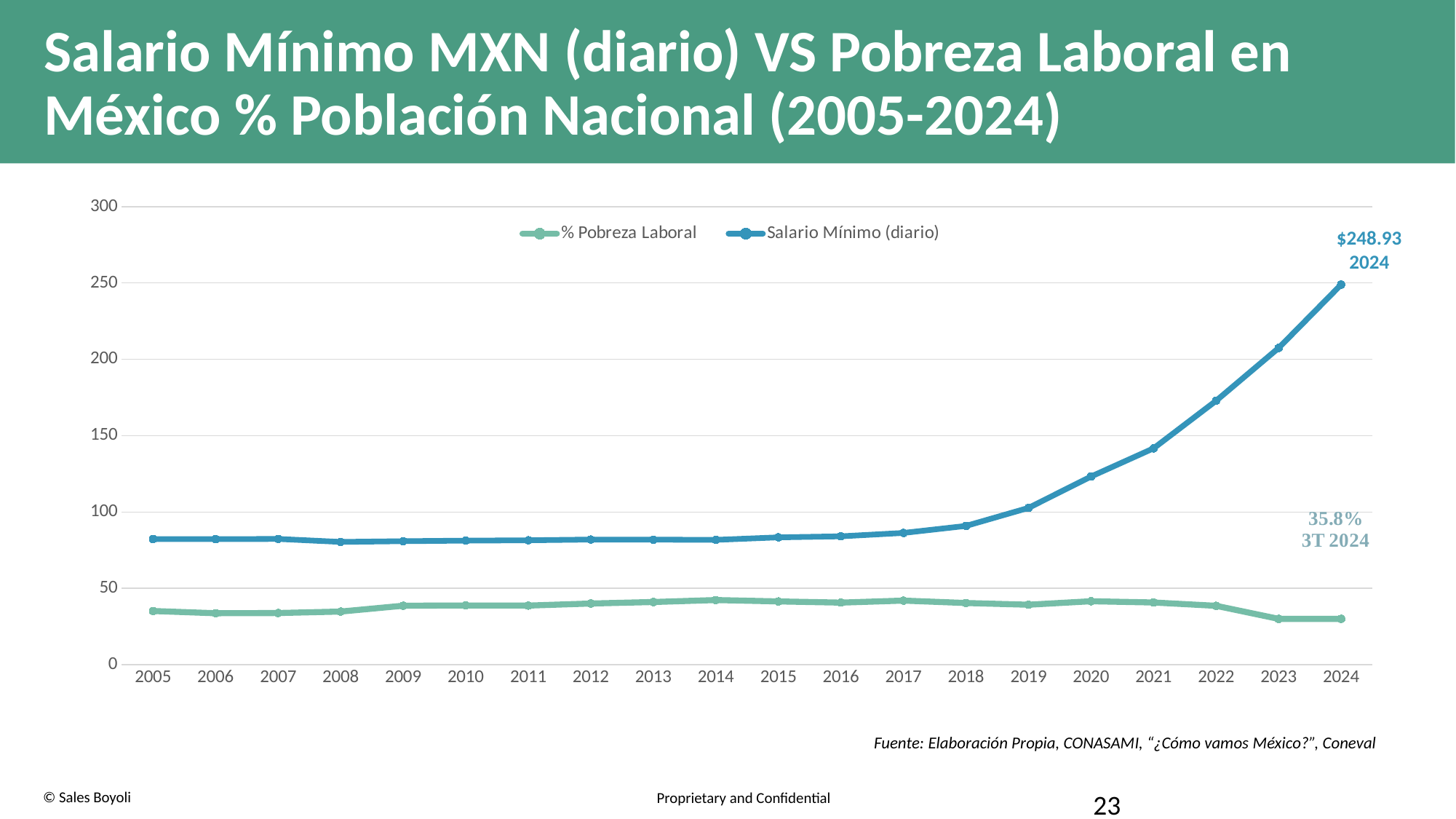
How many years are plotted along the x axis? 20 What is the value of Salario Mínimo (diario) in 2024? $248.93 Is the value for Salario Mínimo (diario) in 2022 greater or less than 150? greater What is the value of % Pobreza Laboral labelled for 3T 2024? 35.8% What colour is the Salario Mínimo (diario) line? blue In which year is Salario Mínimo (diario) highest? 2024 Is the value for % Pobreza Laboral in 2014 greater or less than 50? less Does Salario Mínimo (diario) rise or fall from 2018 to 2024? rise How many series does the legend list? 2 Which is larger: % Pobreza Laboral in 2014 or in 2023? 2014 Is the value for Salario Mínimo (diario) in 2005 greater or less than 100? less What kind of chart is shown on the slide? line chart